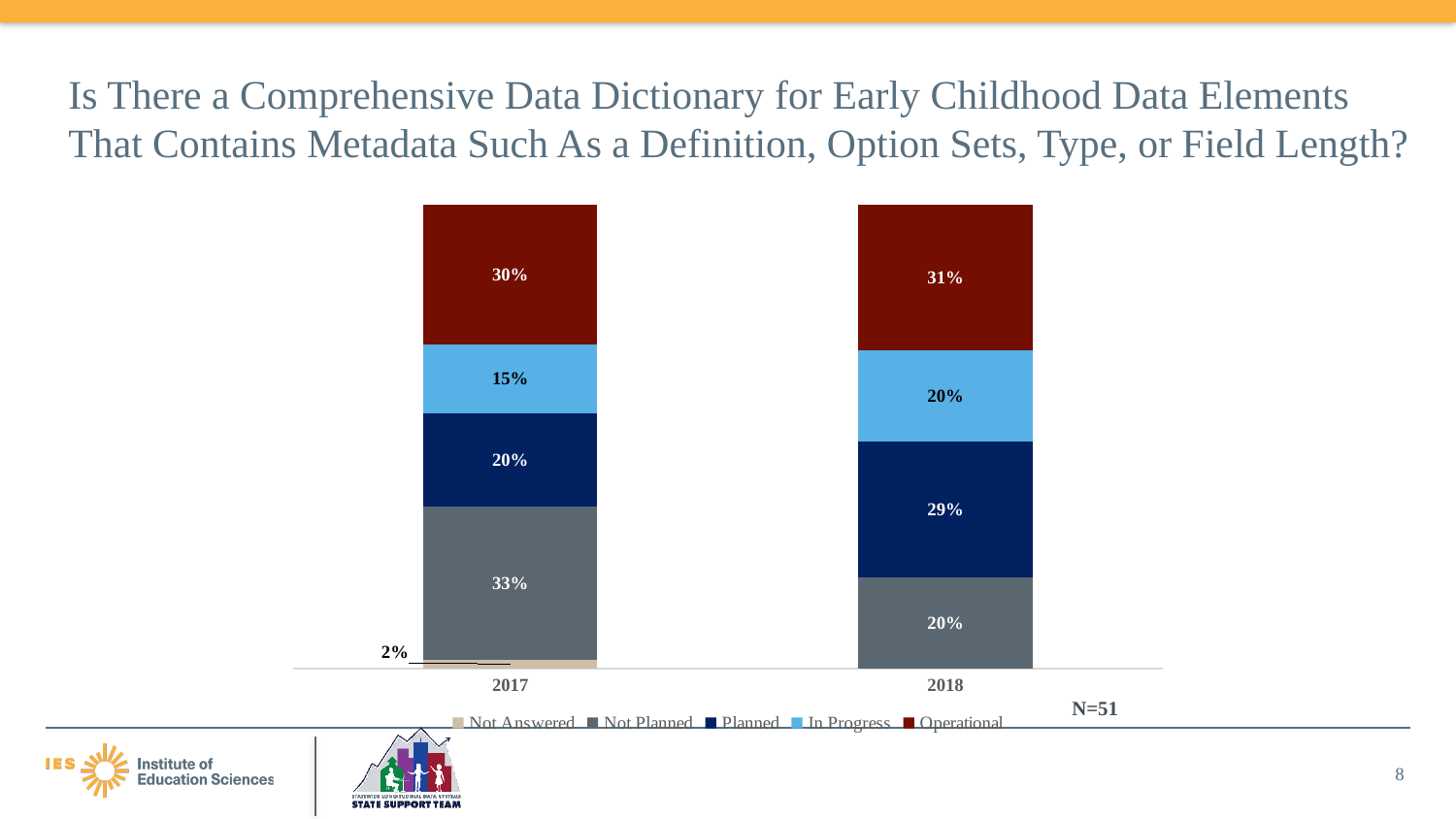
Which is larger, the Planned value in 2017 or the Planned value in 2018? 2018 What percentage is shown for Operational in 2017? 30% What percentage is shown for Not Answered in 2017? 2% Which segment is the largest in the 2018 bar? Operational What kind of chart is shown on the slide? Stacked bar chart What percentage is shown for In Progress in 2017? 15% What percentage is shown for Not Planned in 2018? 20% What is the difference between the Not Planned values for 2017 and 2018? 13% What percentage is shown for Planned in 2018? 29% What sample size (N) is noted on the chart? N=51 How many series does the legend list? 5 Which segment is the largest in the 2017 bar? Not Planned